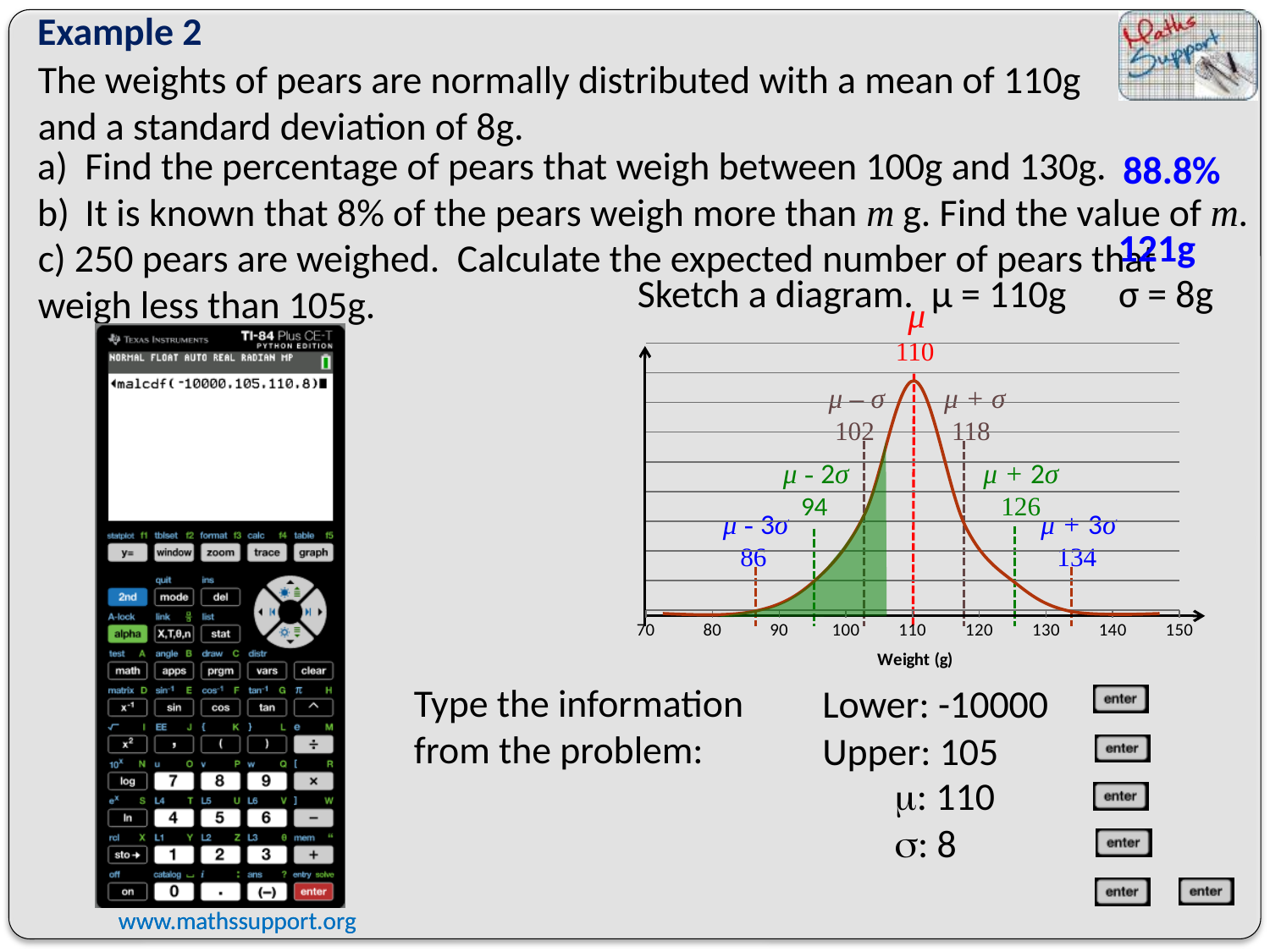
On the normal distribution chart, what weight is labelled at μ + 2σ? 126 What are the lowest and highest values shown on the x-axis of the normal distribution chart? 70 and 150 What is the x-axis title of the normal distribution chart? Weight (g) On the normal distribution chart, at which labelled weight does the curve reach its highest point? 110 On the normal distribution chart, what weight is labelled at μ - 2σ? 94 On the normal distribution chart, what is the difference between the weights labelled at μ + σ and μ – σ? 16 On the normal distribution chart, what weight is labelled at μ + σ? 118 On the normal distribution chart, what weight is labelled at μ - 3σ? 86 On the normal distribution chart, what weight is labelled at μ – σ? 102 On the normal distribution chart, what weight is labelled at μ + 3σ? 134 How many labelled weight positions (μ, μ ± σ, μ ± 2σ, μ ± 3σ) are marked on the normal distribution chart? 7 On the normal distribution chart, what weight is labelled at μ? 110